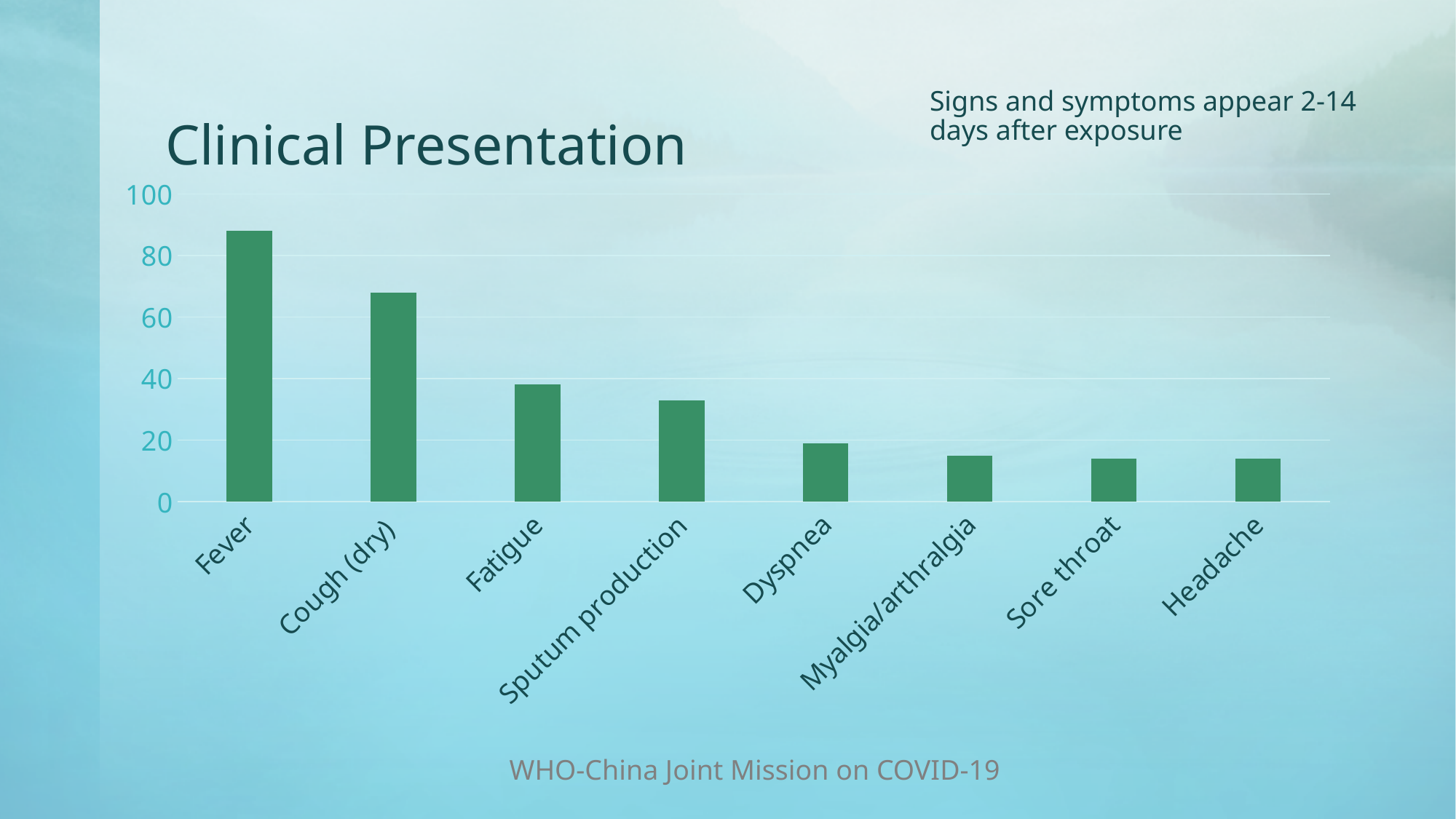
Is the value for Fever greater or less than 80? greater What is the title of the chart on the slide? Clinical Presentation What kind of chart is shown on the slide? bar chart Which is larger, the value for Fever or the value for Cough (dry)? Fever Is the value for Sputum production greater or less than 20? greater How many symptom categories are plotted on the chart? 8 Which is larger, the value for Dyspnea or the value for Fatigue? Fatigue Which symptom has the highest bar on the chart? Fever Is the value for Headache greater or less than 20? less Do the bar values rise or fall moving from left to right along the x axis? fall